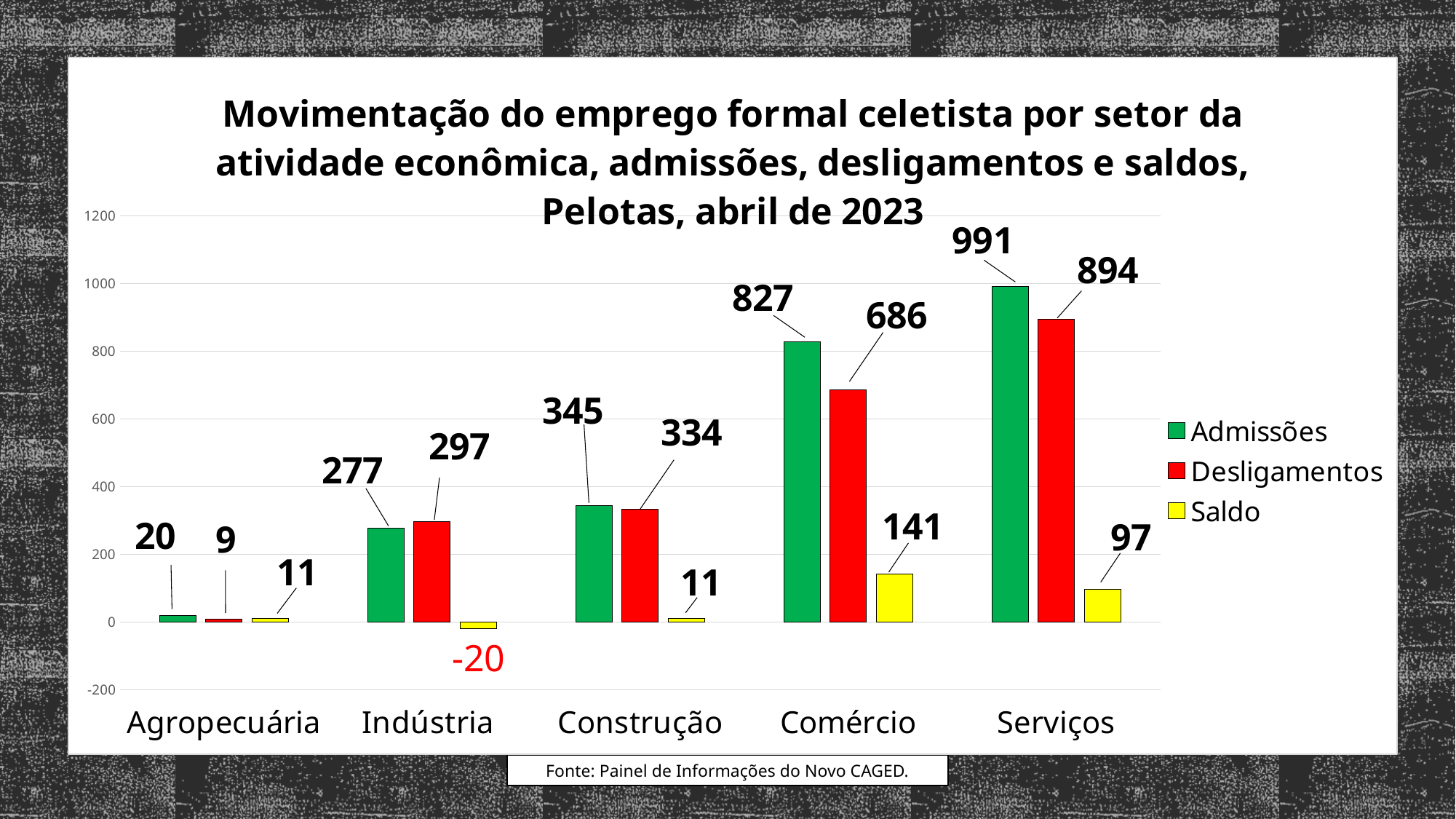
What kind of chart is shown on the slide? Bar chart What is the Saldo value for Indústria? -20 What is the value of Desligamentos for Comércio? 686 How many series does the legend list? 3 Which is larger for Indústria, Admissões or Desligamentos? Desligamentos What is the difference between Admissões and Desligamentos for Construção? 11 What is the value of Admissões for Serviços? 991 How many sectors are shown on the x axis? 5 Which sector has the highest Admissões value? Serviços Which sector has the lowest Desligamentos value? Agropecuária What colour represents the Saldo series in the legend? Yellow Is the Desligamentos value for Serviços greater or less than 800? greater